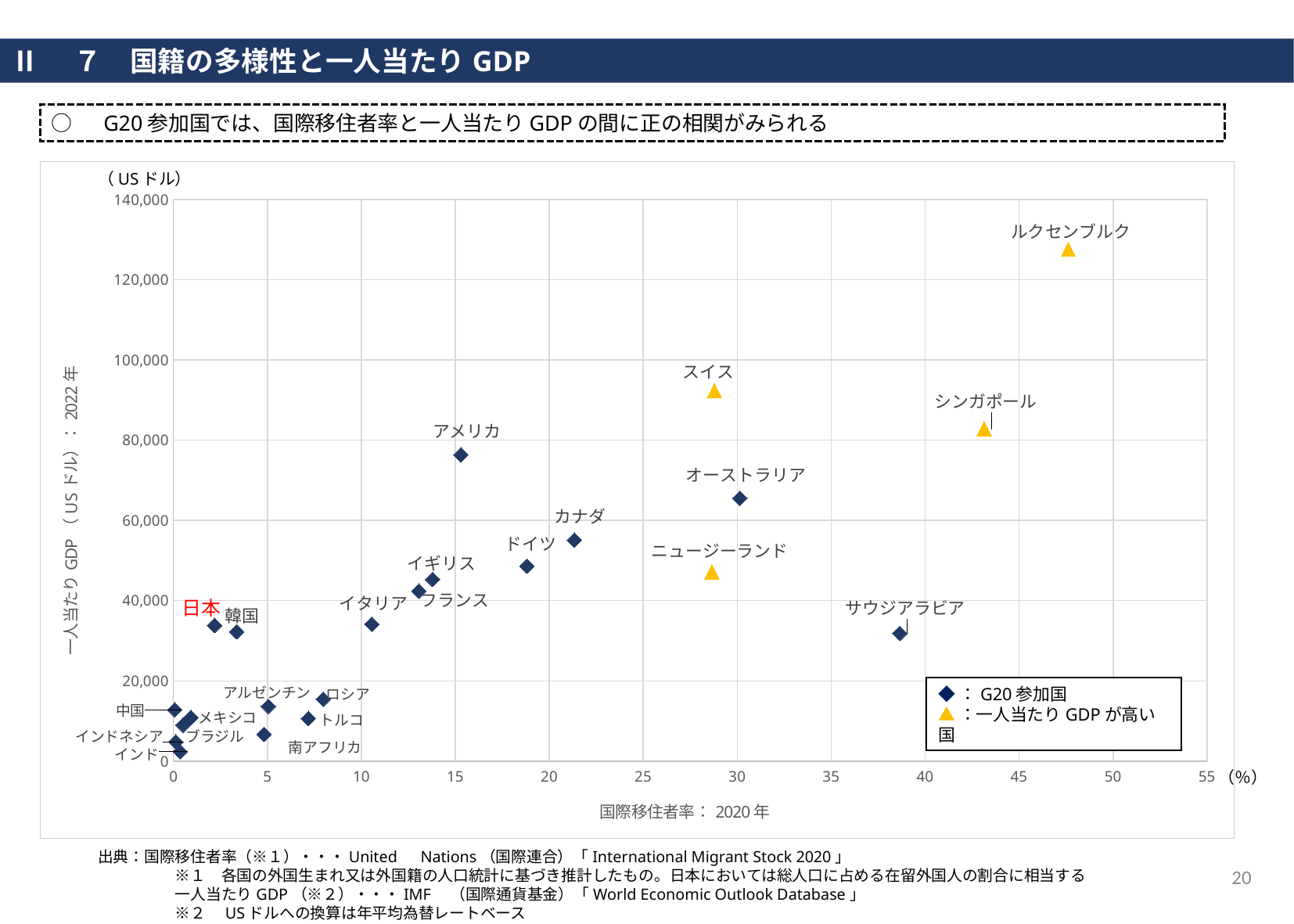
Is the 一人当たりGDP for カナダ greater or less than 60,000? less Is the 一人当たりGDP for アメリカ greater or less than 60,000? greater Is the 国際移住者率 for サウジアラビア greater or less than 35? greater Which has the higher 一人当たりGDP, スイス or シンガポール? スイス How many countries are plotted with the yellow triangle marker (一人当たりGDPが高い国)? 4 Overall, does 一人当たりGDP tend to rise or fall as 国際移住者率 increases along the x axis? rise What kind of chart is shown on the slide? scatter chart How many series does the legend list? 2 Which country has the lowest 一人当たりGDP on the chart? インド Which country has the highest 一人当たりGDP on the chart? ルクセンブルク Which country has the highest 国際移住者率 on the chart? ルクセンブルク